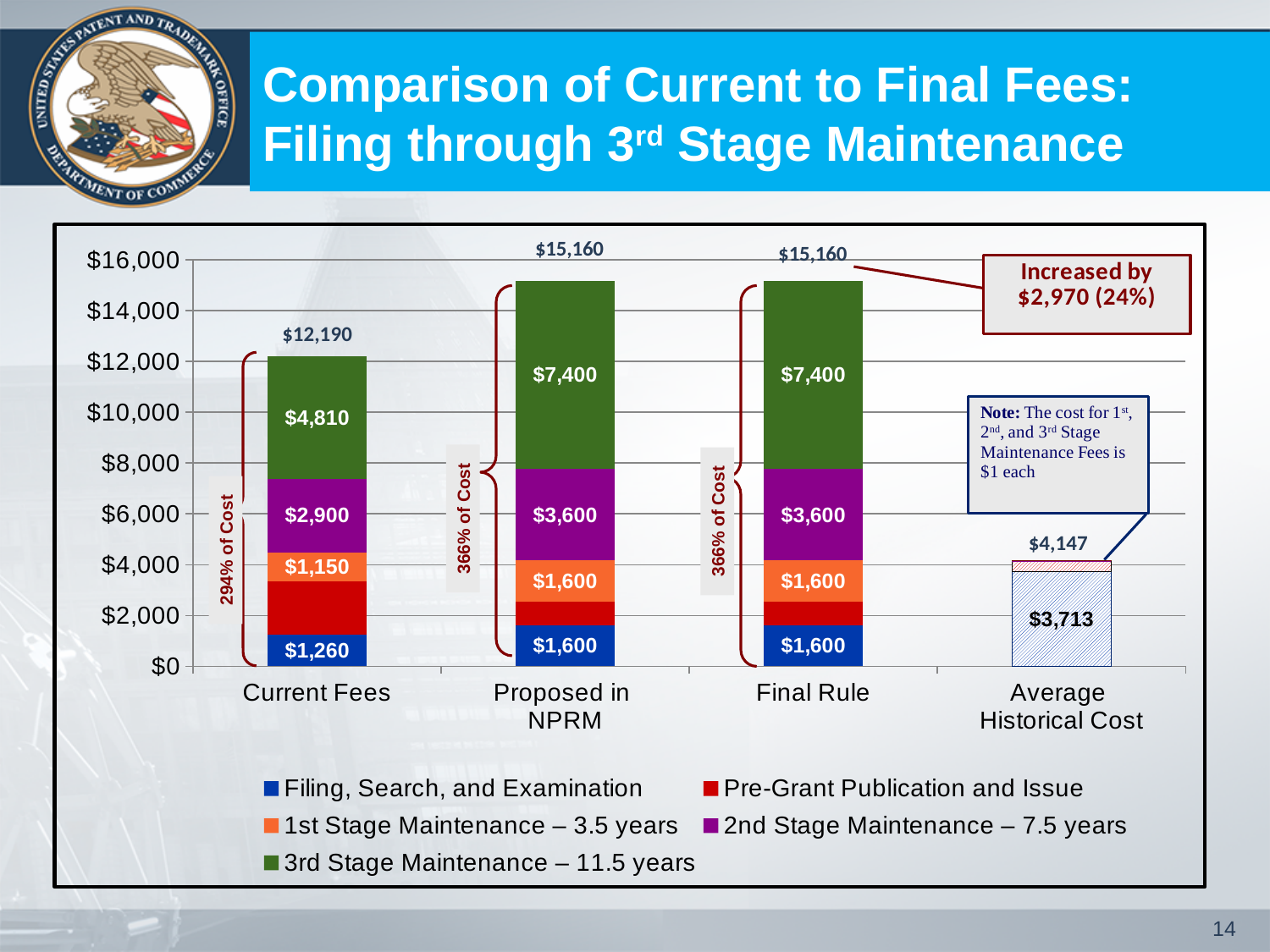
What is the total shown above the Final Rule bar? $15,160 Is the total for Average Historical Cost greater or less than $6,000? less What is the total shown above the Current Fees bar? $12,190 What is the value of 2nd Stage Maintenance – 7.5 years for Proposed in NPRM? $3,600 What is the difference between the Final Rule total and the Current Fees total? $2,970 How many series does the legend list? 5 What kind of chart is shown on the slide? stacked bar chart Which category has the lowest total? Average Historical Cost What is the value of Filing, Search, and Examination for Final Rule? $1,600 What is the value of 3rd Stage Maintenance – 11.5 years for Current Fees? $4,810 Which is larger, the 3rd Stage Maintenance value for Current Fees or for Final Rule? Final Rule What is the difference between the 3rd Stage Maintenance value for Final Rule and for Current Fees? $2,590